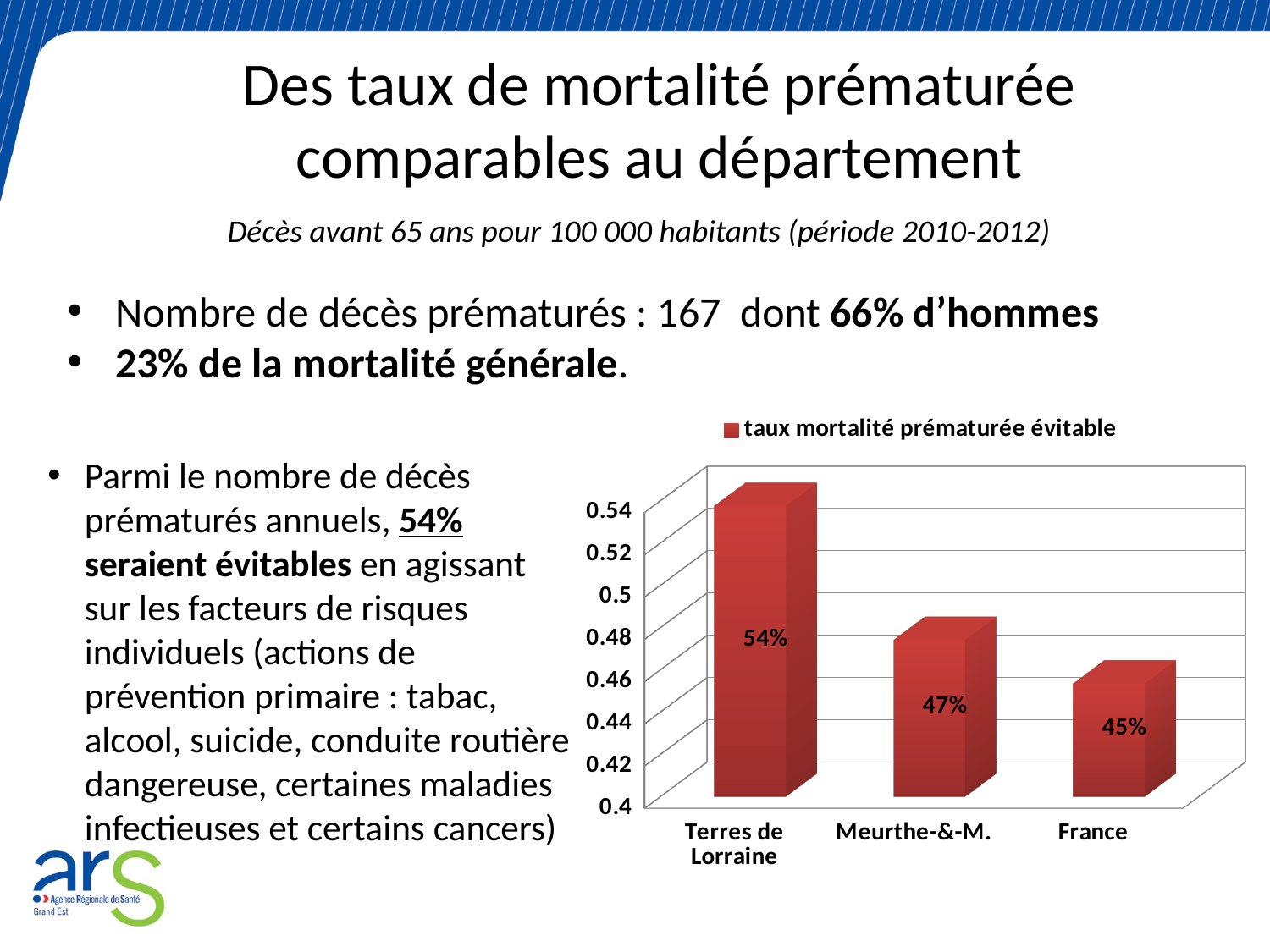
Which is larger, the value for Meurthe-&-M. or the value for France? Meurthe-&-M. What kind of chart is shown on the slide? bar chart How many series does the chart legend list? 1 What is the name of the series shown in the chart legend? taux mortalité prématurée évitable What is the value for France in the chart? 45% What is the difference between the values for Terres de Lorraine and France? 9% Which category has the lowest value in the chart? France What is the value for Meurthe-&-M. in the chart? 47% What is the value for Terres de Lorraine in the chart? 54% How many categories are shown on the x axis of the chart? 3 Which category has the highest value in the chart? Terres de Lorraine What is the difference between the values for Terres de Lorraine and Meurthe-&-M.? 7%